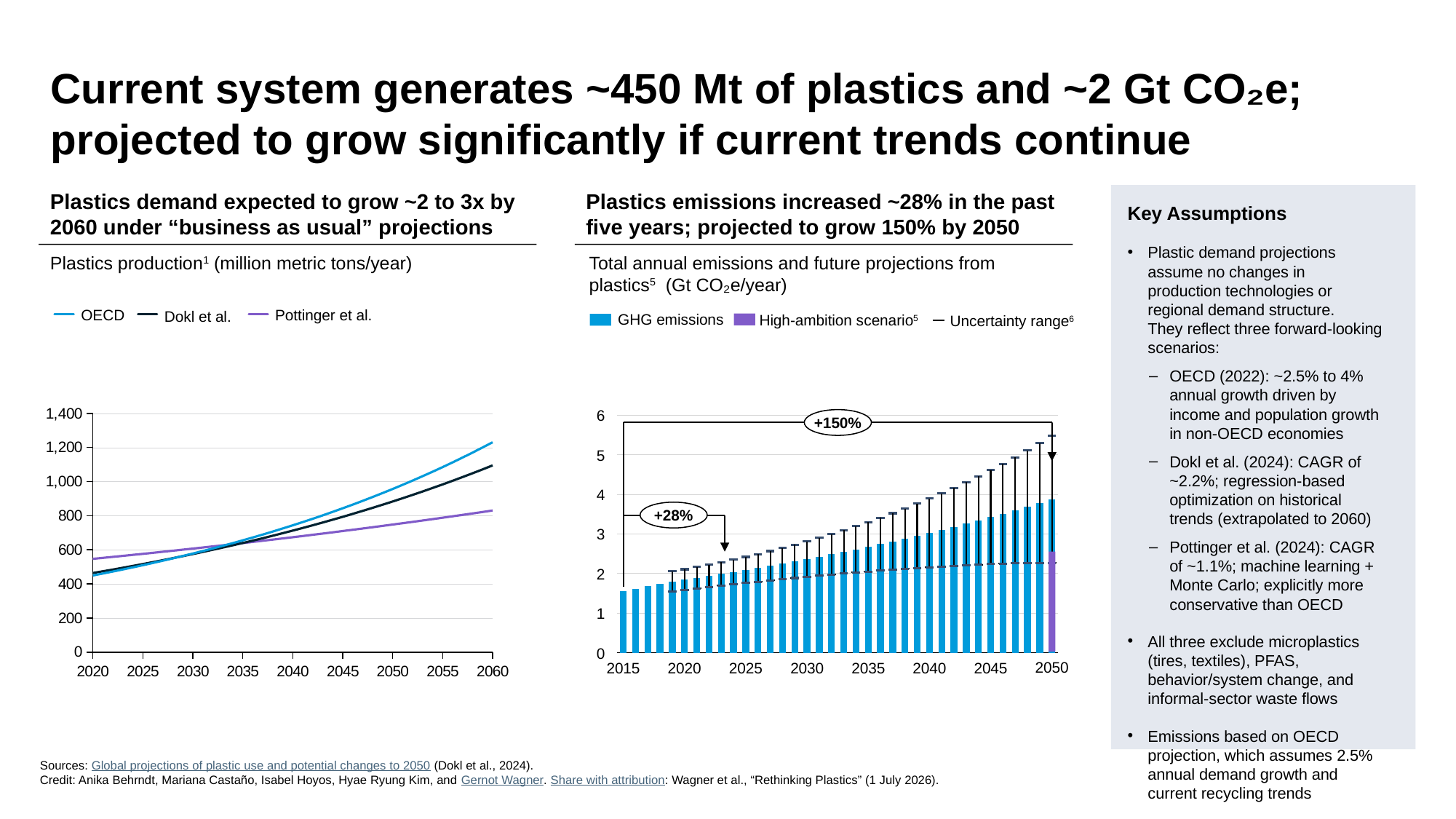
In the left chart (Plastics production), is the Pottinger et al. value for 2060 greater or less than 1,000? less In the left chart (Plastics production), which series has the lowest value in 2060? Pottinger et al. In the left chart (Plastics production), which series has the highest value in 2020? Pottinger et al. What kind of chart is the left chart, 'Plastics production (million metric tons/year)'? line chart What kind of chart is the right chart, 'Total annual emissions and future projections from plastics'? bar chart In the left chart (Plastics production), is the OECD value for 2060 greater or less than 1,000? greater How many entries does the legend of the right chart (Total annual emissions) list? 3 In the left chart (Plastics production), do the OECD values rise or fall from 2020 to 2060? rise In the right chart (Total annual emissions), is the GHG emissions value for 2050 greater or less than 3? greater In the left chart (Plastics production), which series has the highest value in 2060? OECD How many series does the legend of the left chart (Plastics production) list? 3 In the right chart (Total annual emissions), what percentage increase is annotated between 2015 and 2050? +150%